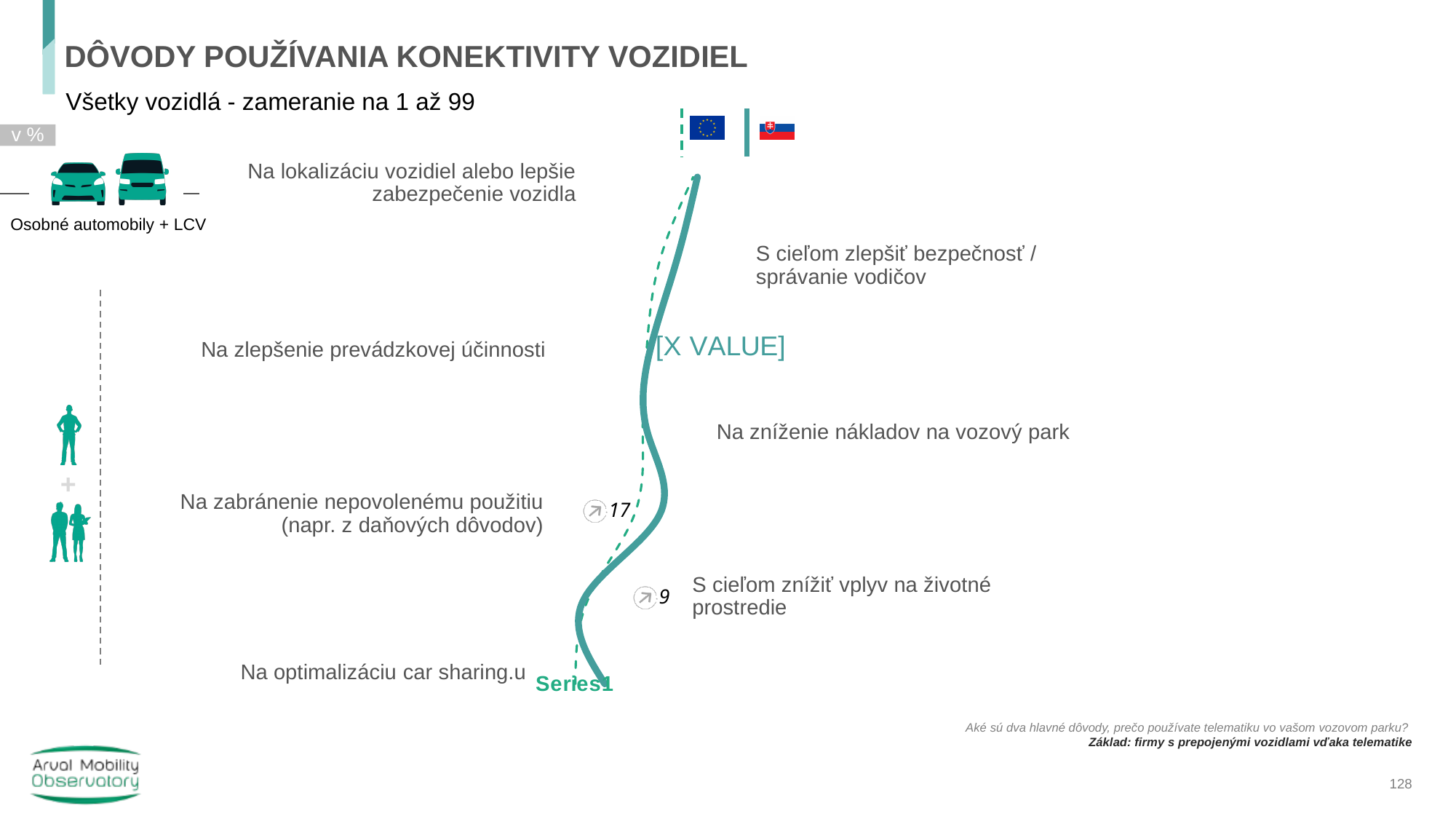
What kind of chart is shown on the slide? line chart Do the plotted values rise or fall when moving down the list of categories from top to bottom? fall Which has the larger value: 'Na lokalizáciu vozidiel alebo lepšie zabezpečenie vozidla' or 'Na optimalizáciu car sharing'? Na lokalizáciu vozidiel alebo lepšie zabezpečenie vozidla What data label is printed next to 'Na zabránenie nepovolenému použitiu (napr. z daňových dôvodov)'? 17 What is the title of the slide containing the chart? DÔVODY POUŽÍVANIA KONEKTIVITY VOZIDIEL Which category has the highest value on the chart? Na lokalizáciu vozidiel alebo lepšie zabezpečenie vozidla In what unit are the chart values expressed, according to the label at the top left? v % Which has the larger value: 'Na zníženie nákladov na vozový park' or 'S cieľom znížiť vplyv na životné prostredie'? Na zníženie nákladov na vozový park What data label is printed next to 'S cieľom znížiť vplyv na životné prostredie'? 9 How many lines (series) are plotted on the chart? 2 How many reason categories are plotted on the chart? 7